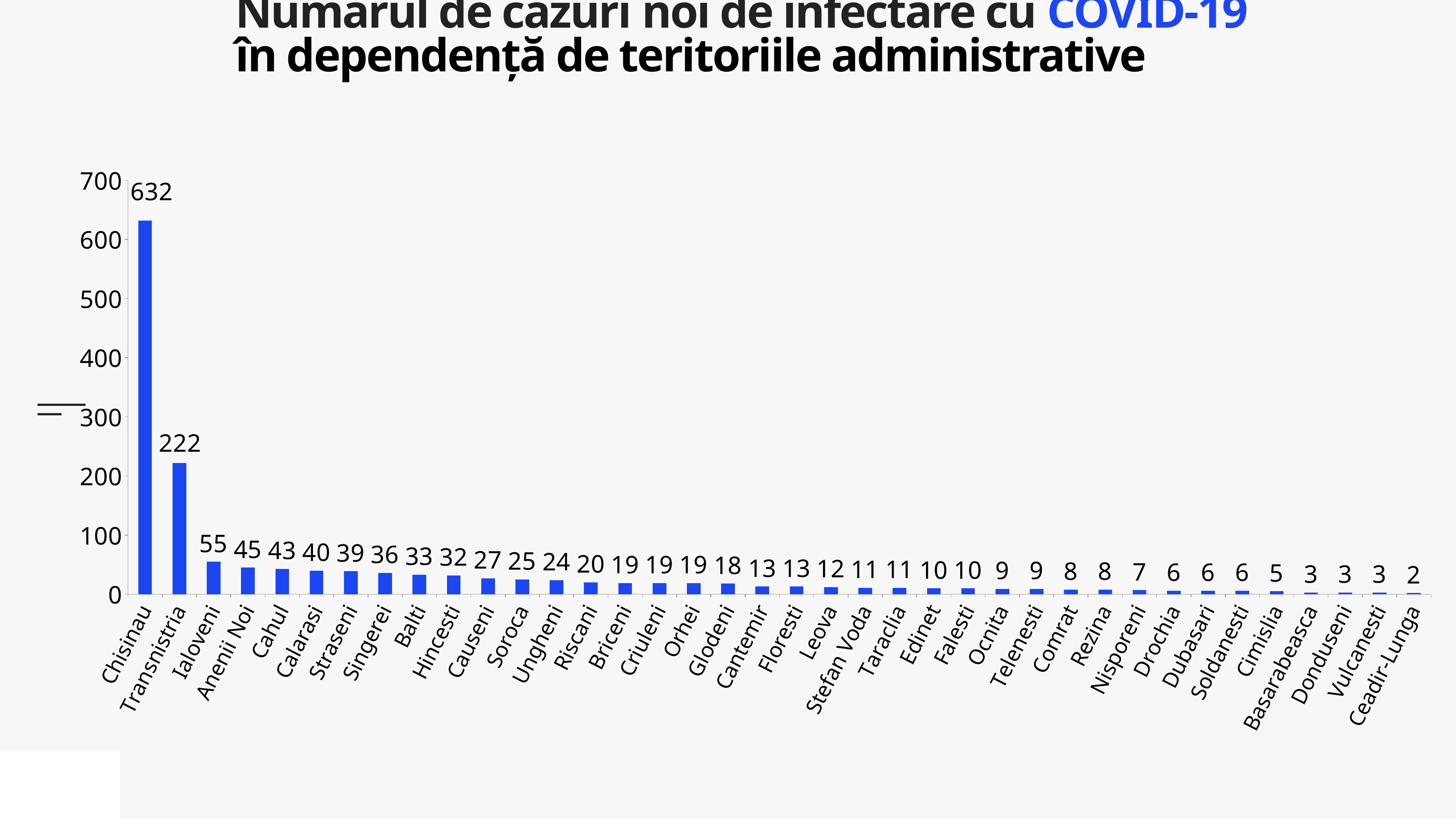
What is the value for Transnistria? 222 What is the value for Chisinau? 632 Which category has the highest value? Chisinau What is the difference between the values for Chisinau and Transnistria? 410 What is the difference between the values for Ialoveni and Cahul? 12 What is the value for Balti? 33 What kind of chart is shown on the slide? Bar chart Do the values rise or fall from left to right along the x axis? Fall How many categories are shown on the x axis? 38 What is the value for Soroca? 25 Which category has the lowest value? Ceadir-Lunga Which is larger, the value for Ungheni or the value for Glodeni? Ungheni